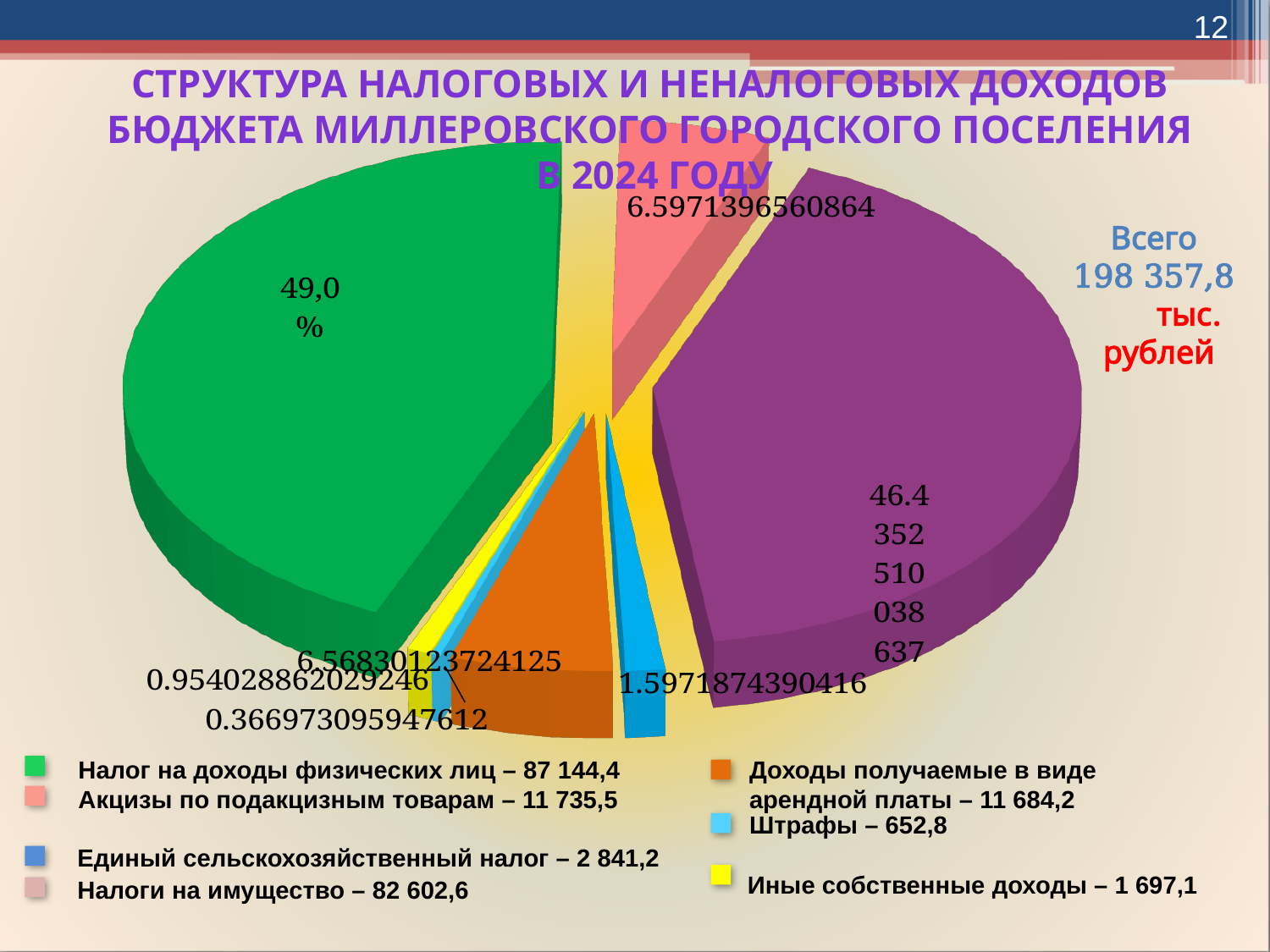
What data label is printed on the large purple slice? 46.4352510038637 Which is larger according to the legend: Акцизы по подакцизным товарам or Доходы получаемые в виде арендной платы? Акцизы по подакцизным товарам What is the total (Всего) shown on the slide? 198 357,8 тыс. рублей How many slices does the pie chart have? 7 What is the difference between the legend values for Налог на доходы физических лиц (87 144,4) and Налоги на имущество (82 602,6)? 4 541,8 What percentage label is shown on the green slice (Налог на доходы физических лиц)? 49,0 % Which category has the largest slice of the pie? Налог на доходы физических лиц How many revenue categories does the legend list? 7 According to the legend, what is the value for Налоги на имущество? 82 602,6 According to the legend, what is the value for Штрафы? 652,8 Which year does the chart title refer to? 2024 What kind of chart is shown on the slide? pie chart